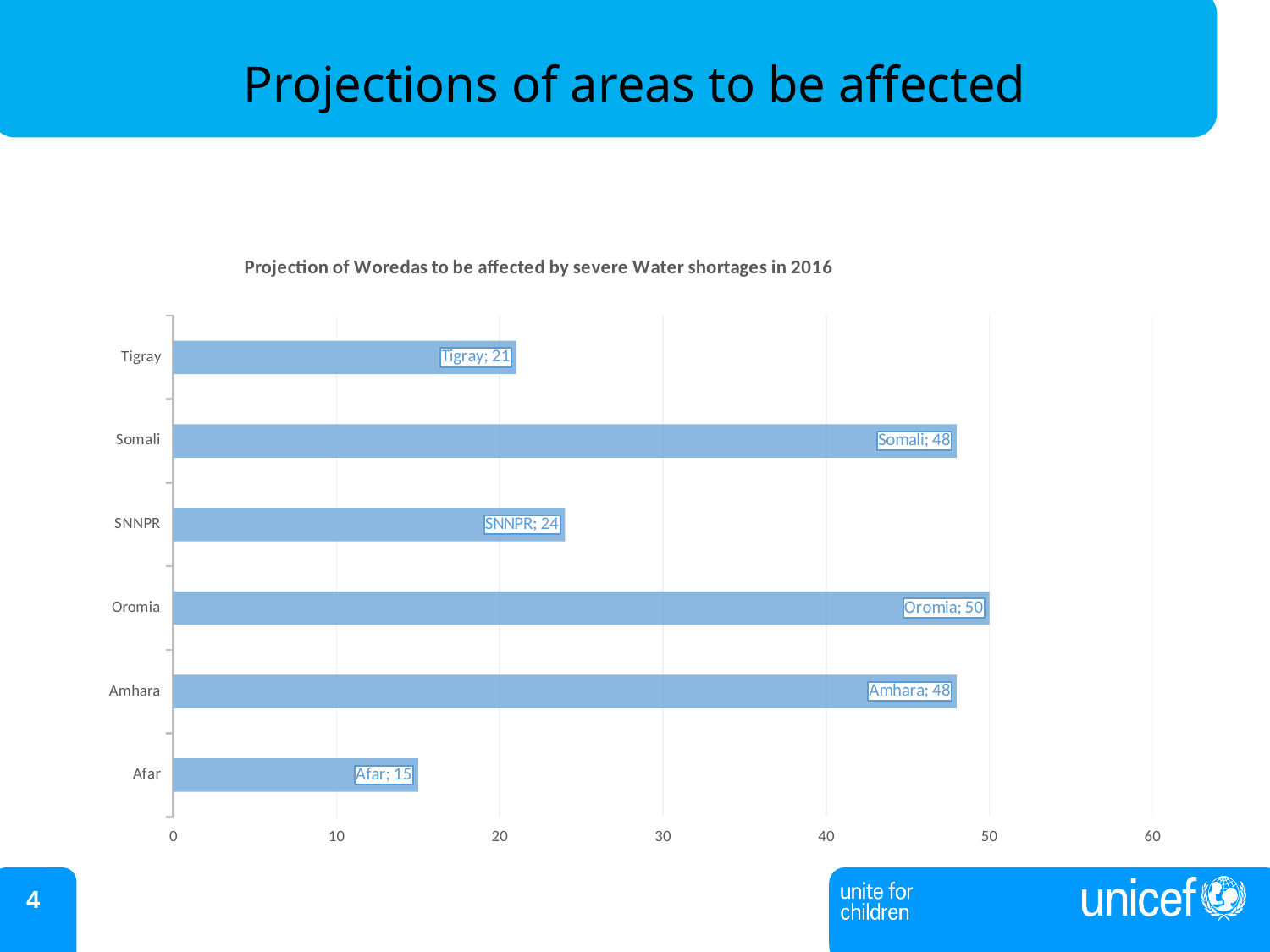
What kind of chart is shown on the slide? Bar chart What is the projected number of woredas to be affected in Oromia? 50 What is the title of the chart? Projection of Woredas to be affected by severe Water shortages in 2016 What is the highest value labelled on the horizontal axis? 60 What is the value shown for SNNPR? 24 How many regions are shown in the chart? 6 Which region has the highest projected number of affected woredas? Oromia Which has a larger value, SNNPR or Tigray? SNNPR Is the value for Amhara greater or less than 40? greater Which region has the lowest projected number of affected woredas? Afar What is the value shown for Afar? 15 What is the difference between the values for Somali and Tigray? 27